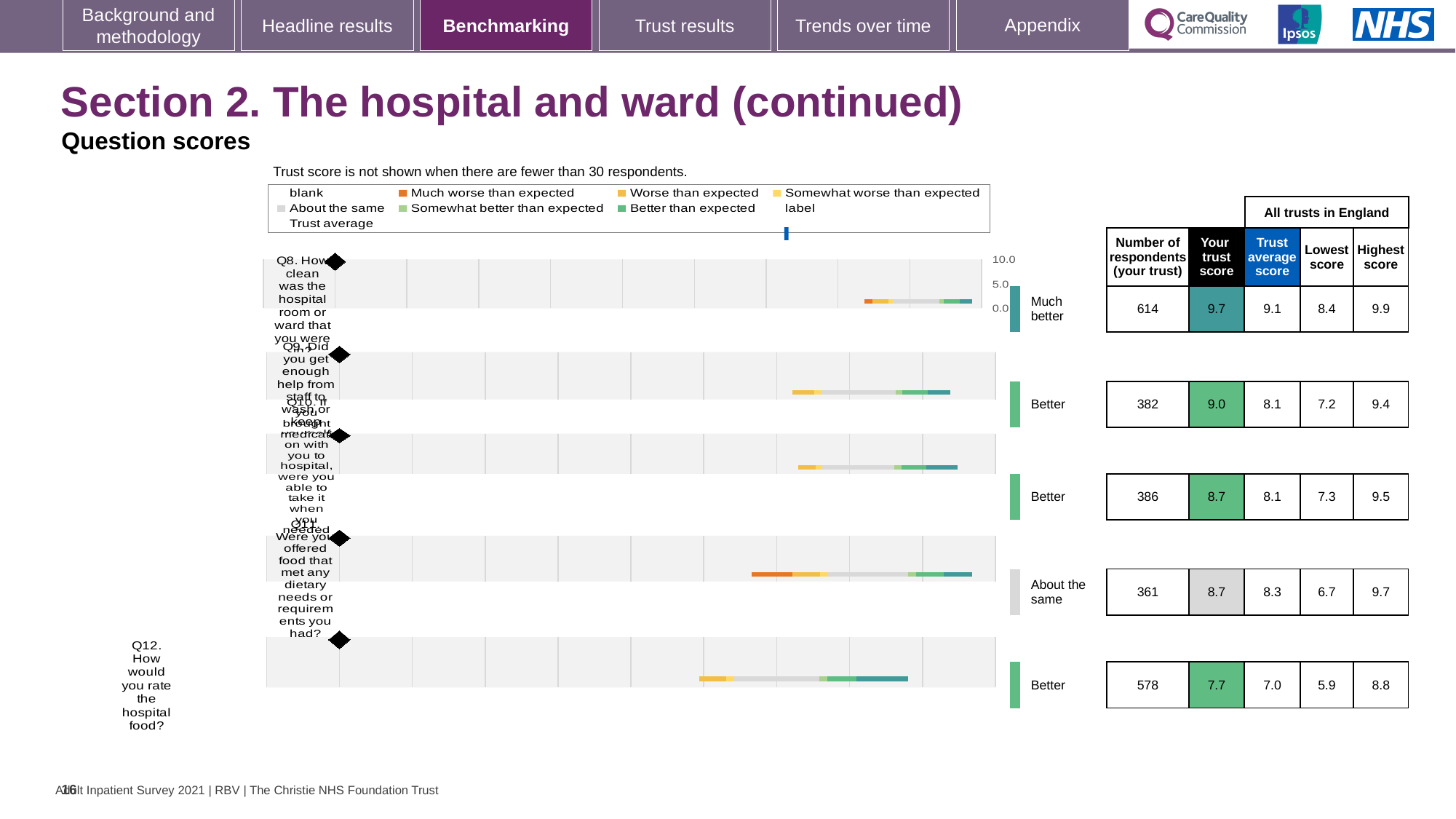
Is the trust score for Q12 greater or less than 5.0? greater How many questions (Q8 to Q12) are plotted on the chart? 5 Which question has the lowest 'Your trust score'? Q12 Which has the larger trust score, Q9 or Q12? Q9 What is the trust score for Q8 (How clean was the hospital room or ward)? 9.7 What benchmark category is shown for Q11 (Were you offered food that met any dietary needs)? About the same What is the lowest score across all trusts in England for Q12? 5.9 What kind of chart is shown on the slide? bar chart What is the trust average score for Q11? 8.3 What is the number of respondents for Q12 (How would you rate the hospital food)? 578 Which question has the highest 'Your trust score'? Q8 What is the difference between the trust score and the trust average score for Q8? 0.6